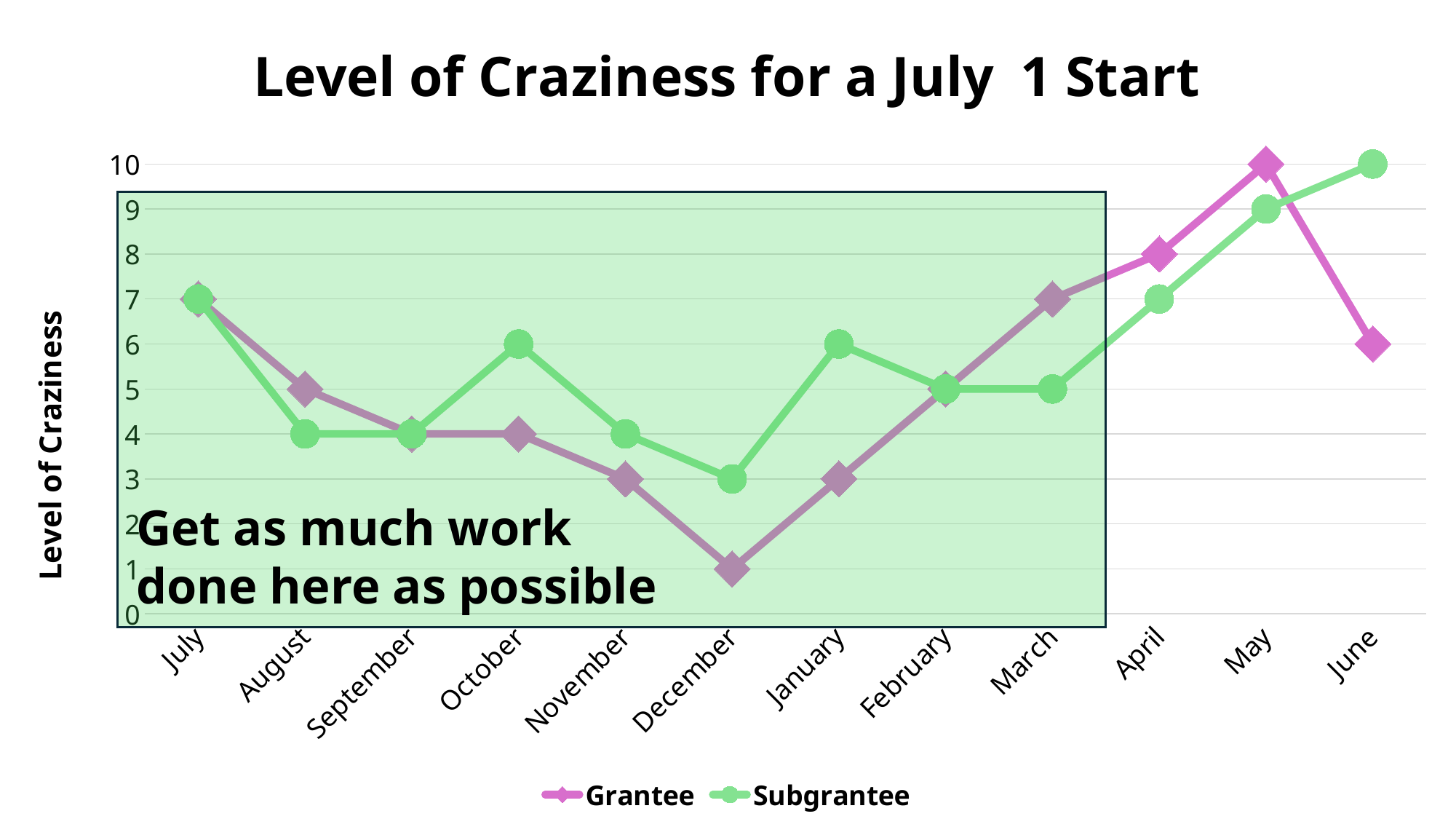
How many months are plotted along the x axis? 12 What is the difference between the Grantee and Subgrantee values in June? 4 How many series does the legend list? 2 What is the title of the chart? Level of Craziness for a July 1 Start In which month is the Grantee level of craziness lowest? December What is the Grantee value for May? 10 What is the Subgrantee value for June? 10 Does the Grantee line rise or fall from December to May? Rise What kind of chart is shown on the slide? Line chart In October, which series has the higher value, Grantee or Subgrantee? Subgrantee In which month is the Subgrantee level of craziness highest? June What is the Grantee value for December? 1